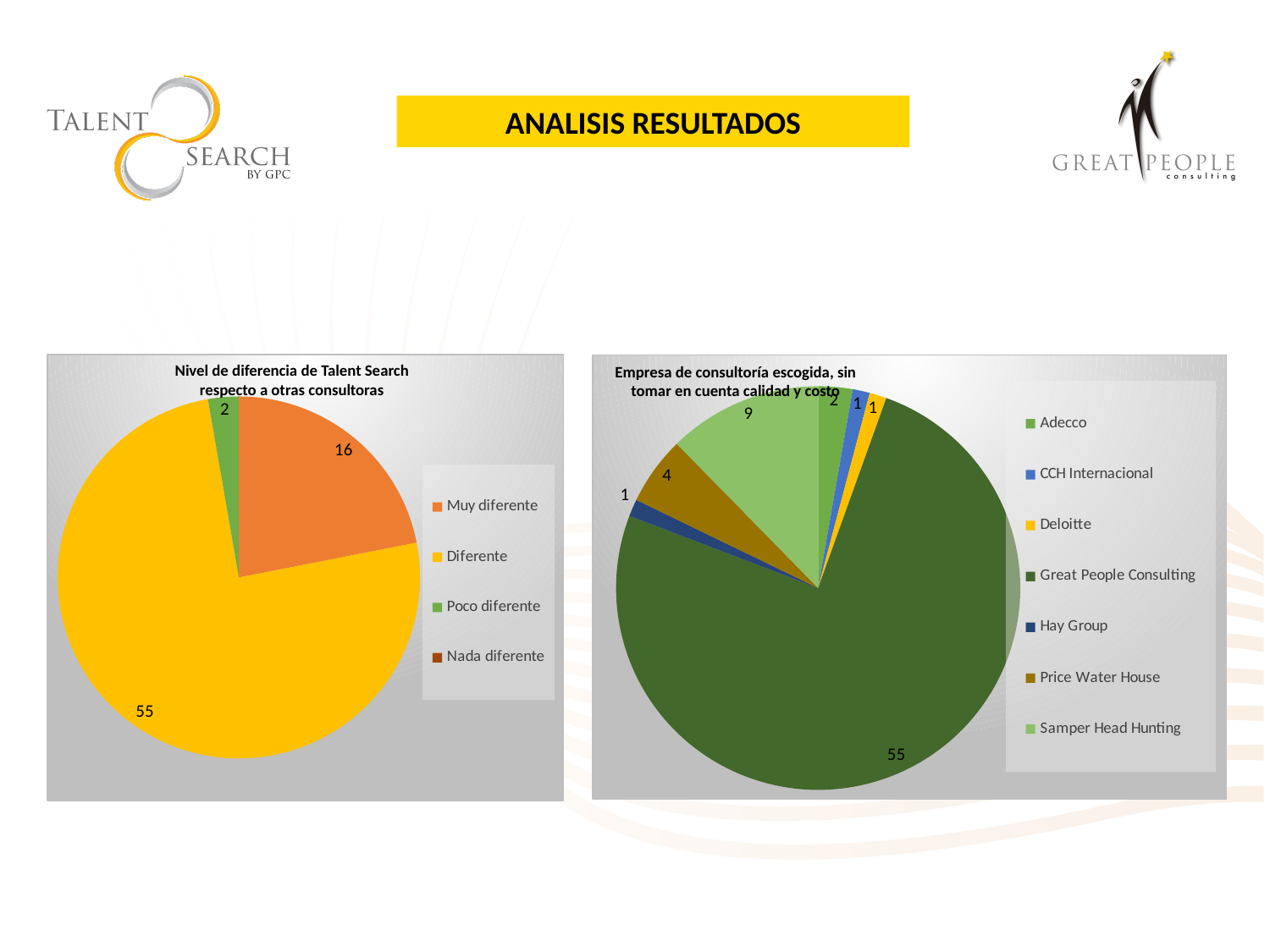
In the chart titled 'Nivel de diferencia de Talent Search respecto a otras consultoras', how many entries does the legend list? 4 In the chart titled 'Empresa de consultoría escogida, sin tomar en cuenta calidad y costo', what is the value for 'Samper Head Hunting'? 9 What kind of chart is the chart titled 'Empresa de consultoría escogida, sin tomar en cuenta calidad y costo'? Pie chart In the chart titled 'Empresa de consultoría escogida, sin tomar en cuenta calidad y costo', what is the value for 'Price Water House'? 4 In the chart titled 'Nivel de diferencia de Talent Search respecto a otras consultoras', which category has the largest slice? Diferente In the chart titled 'Empresa de consultoría escogida, sin tomar en cuenta calidad y costo', what is the value for 'Great People Consulting'? 55 In the chart titled 'Empresa de consultoría escogida, sin tomar en cuenta calidad y costo', which is larger, the value for 'Samper Head Hunting' or the value for 'Price Water House'? Samper Head Hunting In the chart titled 'Nivel de diferencia de Talent Search respecto a otras consultoras', what is the value for 'Muy diferente'? 16 In the chart titled 'Nivel de diferencia de Talent Search respecto a otras consultoras', what is the value for 'Diferente'? 55 In the chart titled 'Empresa de consultoría escogida, sin tomar en cuenta calidad y costo', how many companies does the legend list? 7 In the chart titled 'Empresa de consultoría escogida, sin tomar en cuenta calidad y costo', which company has the largest slice? Great People Consulting In the chart titled 'Nivel de diferencia de Talent Search respecto a otras consultoras', what is the difference between the values for 'Diferente' and 'Muy diferente'? 39